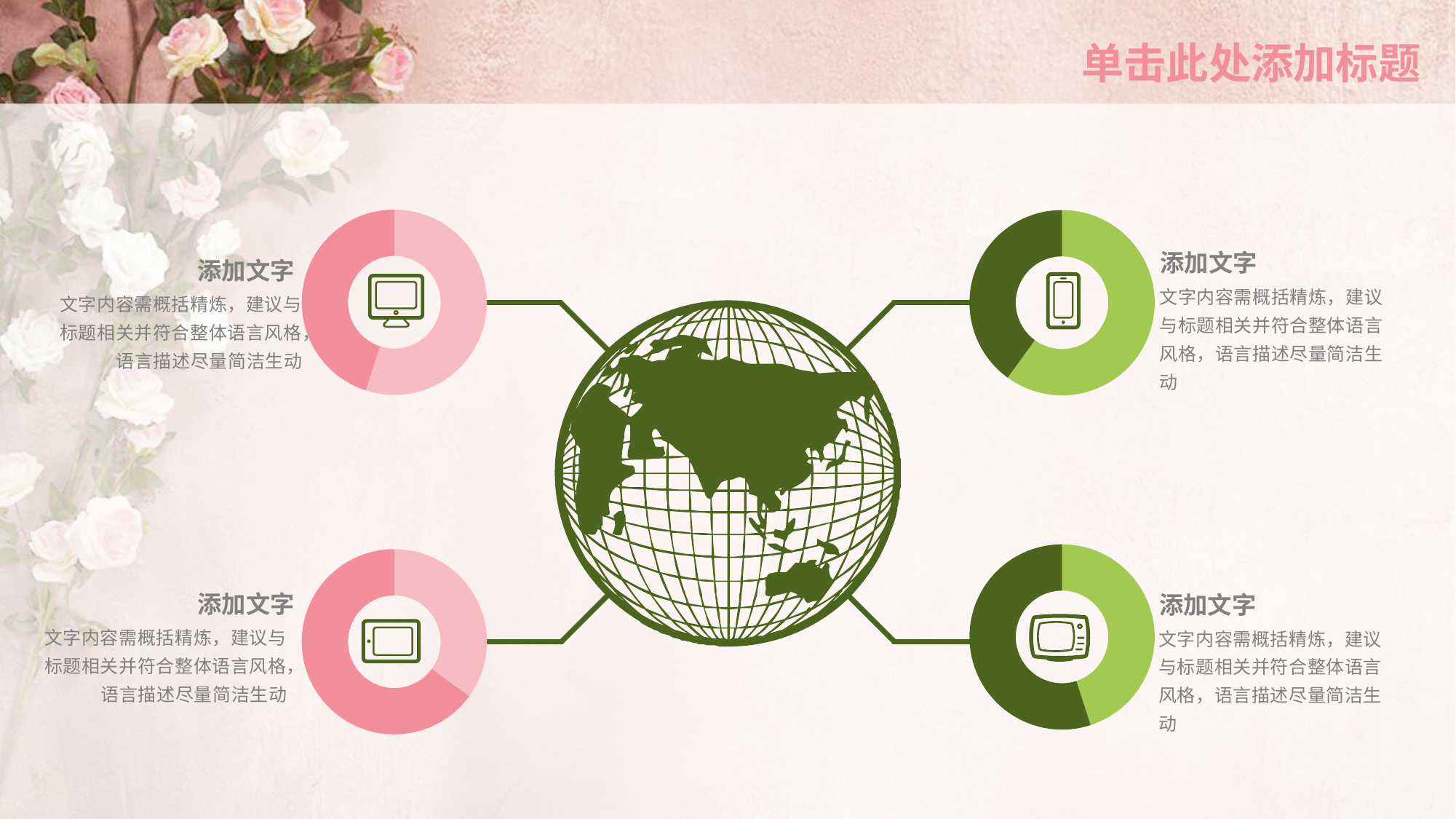
How many doughnut charts are on the slide? 4 In the top-right doughnut chart, which segment is larger, the dark green or the light green? light green What colour are the two doughnut charts on the left side of the slide? pink In the bottom-right doughnut chart, which segment is larger, the dark green or the light green? dark green What kind of chart is the top-left chart on the slide? doughnut chart In the bottom-left doughnut chart, which segment is larger, the dark pink or the light pink? dark pink How many segments does each doughnut chart on the slide have? 2 What colour are the two doughnut charts on the right side of the slide? green